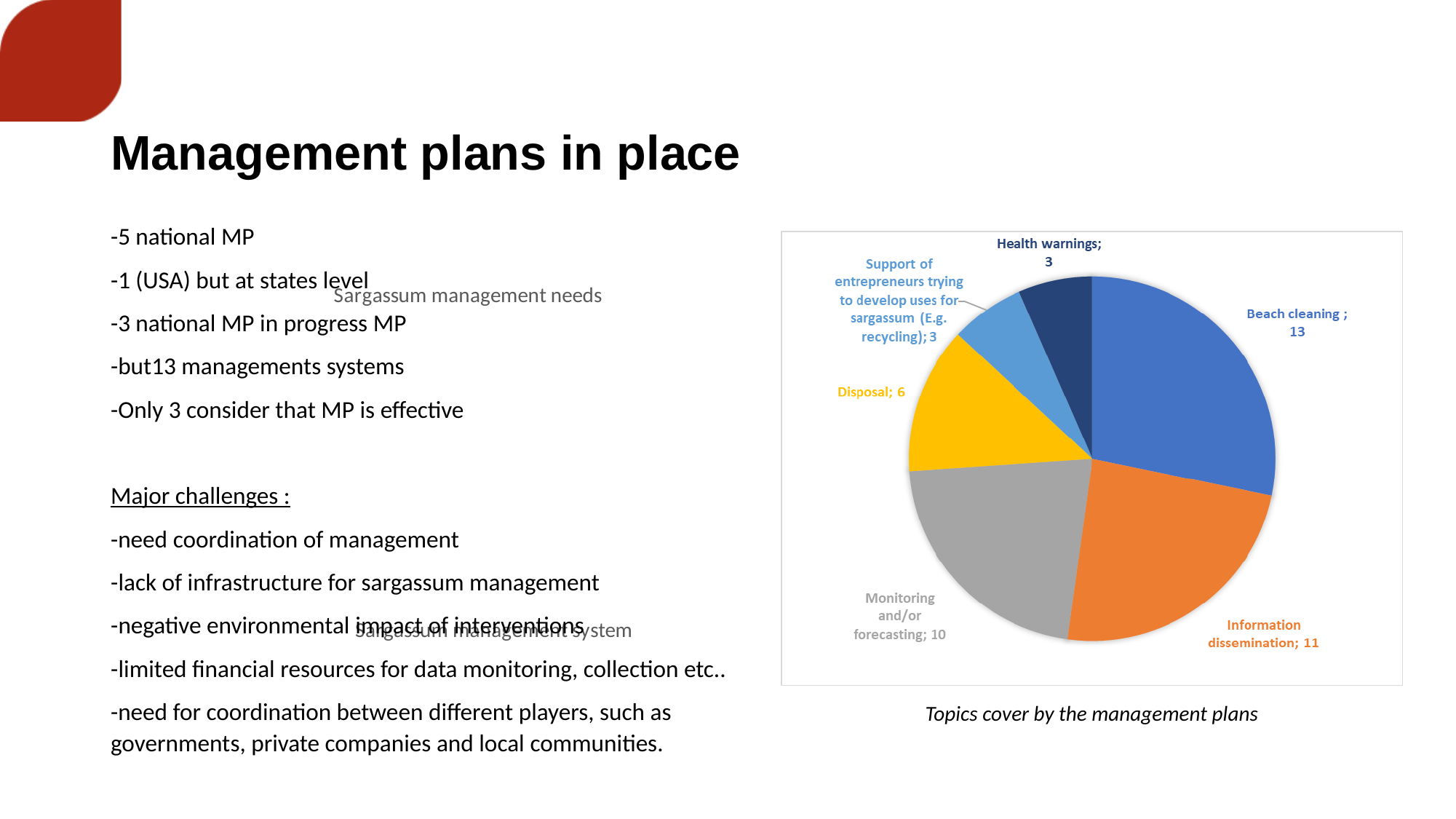
What is the caption written below the pie chart? Topics cover by the management plans What kind of chart is shown on the slide? pie chart What is the difference between the values for Beach cleaning and Information dissemination? 2 Which topic has the largest slice in the pie chart? Beach cleaning What is the value for Monitoring and/or forecasting in the pie chart? 10 What is the value for Information dissemination in the pie chart? 11 What is the value for Disposal in the pie chart? 6 What is the value for Beach cleaning in the pie chart? 13 What is the difference between the values for Beach cleaning and Disposal? 7 How many slices does the pie chart have? 6 Which is larger in the pie chart, Disposal or Health warnings? Disposal What is the value for Health warnings in the pie chart? 3